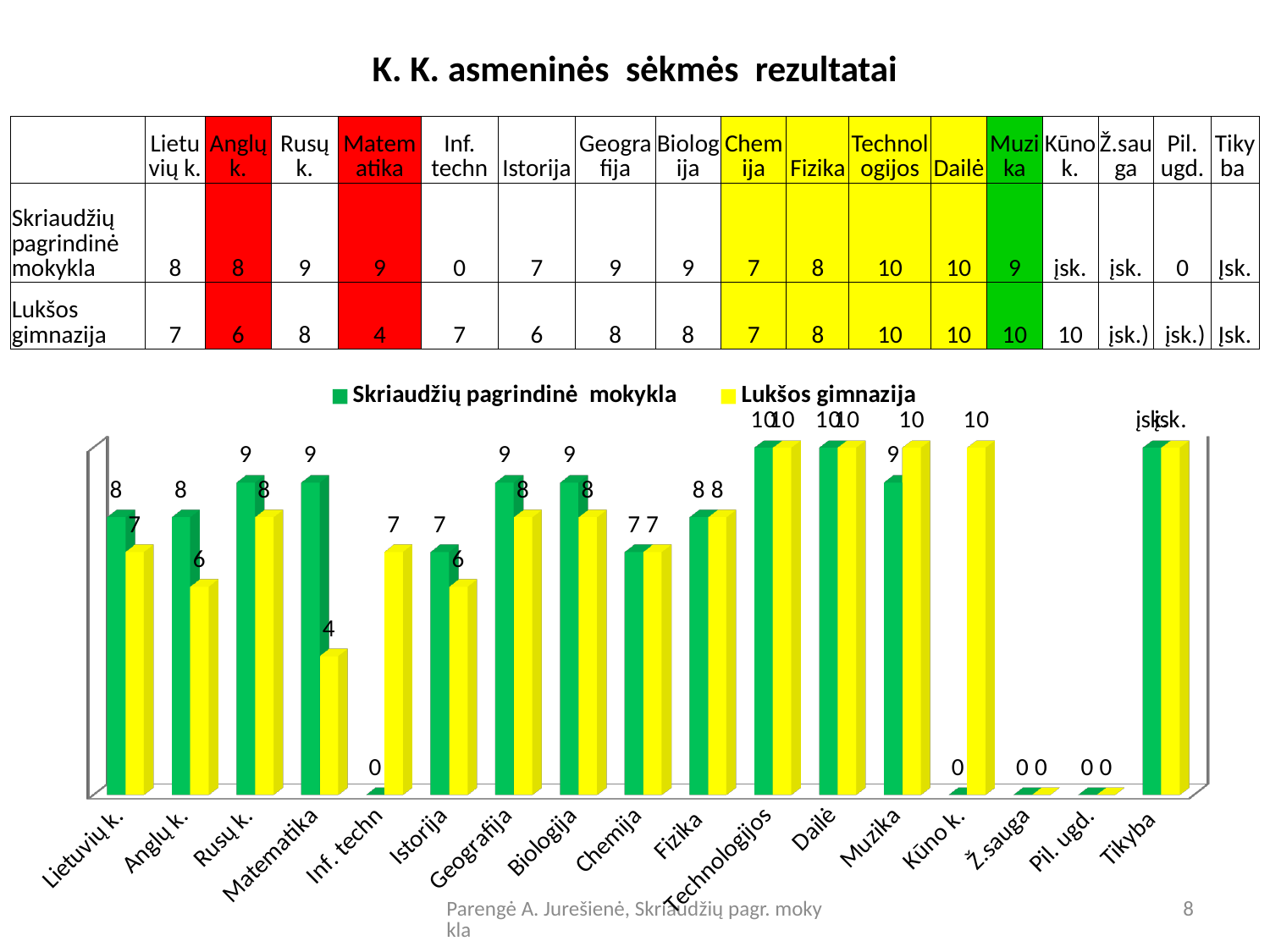
Which is larger for Anglų k.: Skriaudžių pagrindinė mokykla or Lukšos gimnazija? Skriaudžių pagrindinė mokykla What is the value for Matematika for Lukšos gimnazija? 4 What is the value for Inf. techn for Skriaudžių pagrindinė mokykla? 0 What is the value for Muzika for Lukšos gimnazija? 10 Which colour represents Lukšos gimnazija in the chart? yellow What is the value for Chemija for Lukšos gimnazija? 7 What is the difference between the Lukšos gimnazija and Skriaudžių pagrindinė mokykla values for Inf. techn? 7 How many series does the chart legend list? 2 What is the difference between the Skriaudžių pagrindinė mokykla and Lukšos gimnazija values for Matematika? 5 What kind of chart is shown on the slide? bar chart Which is larger for Kūno k.: Skriaudžių pagrindinė mokykla or Lukšos gimnazija? Lukšos gimnazija How many categories are shown on the x axis of the chart? 17